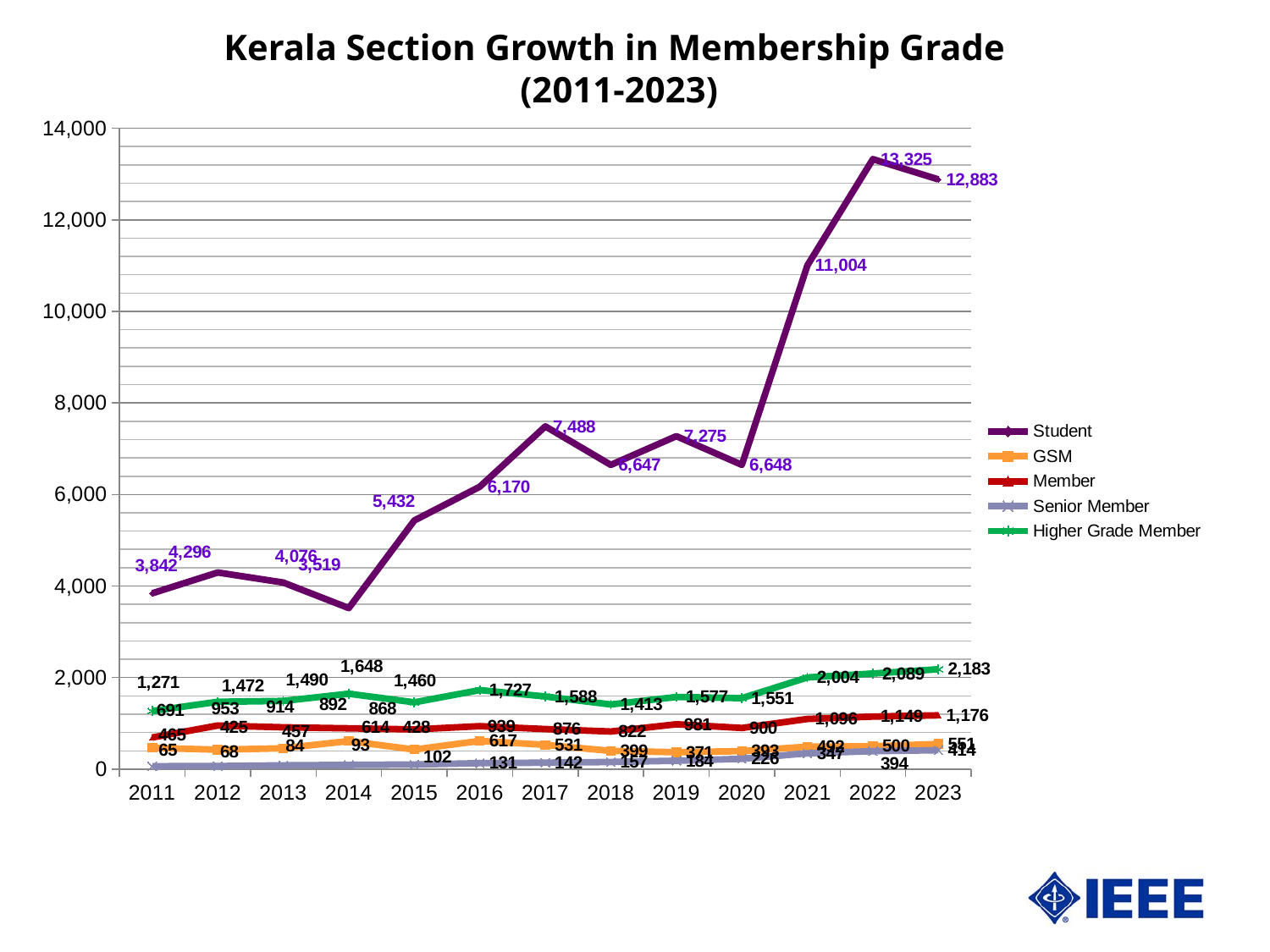
What kind of chart is shown on the slide? line chart What is the difference between the Student values in 2022 and 2023? 442 What is the Student value in 2022? 13,325 In which year is the Student value lowest? 2014 In which year does the Student series reach its highest value? 2022 Does the Higher Grade Member series rise or fall from 2020 to 2023? rise Which is larger, the Student value in 2017 or in 2019? 2017 How many series does the legend list? 5 How many years are plotted on the x axis? 13 What is the Higher Grade Member value in 2023? 2,183 What is the Senior Member value in 2020? 226 Is the Student value for 2021 greater or less than 10,000? greater